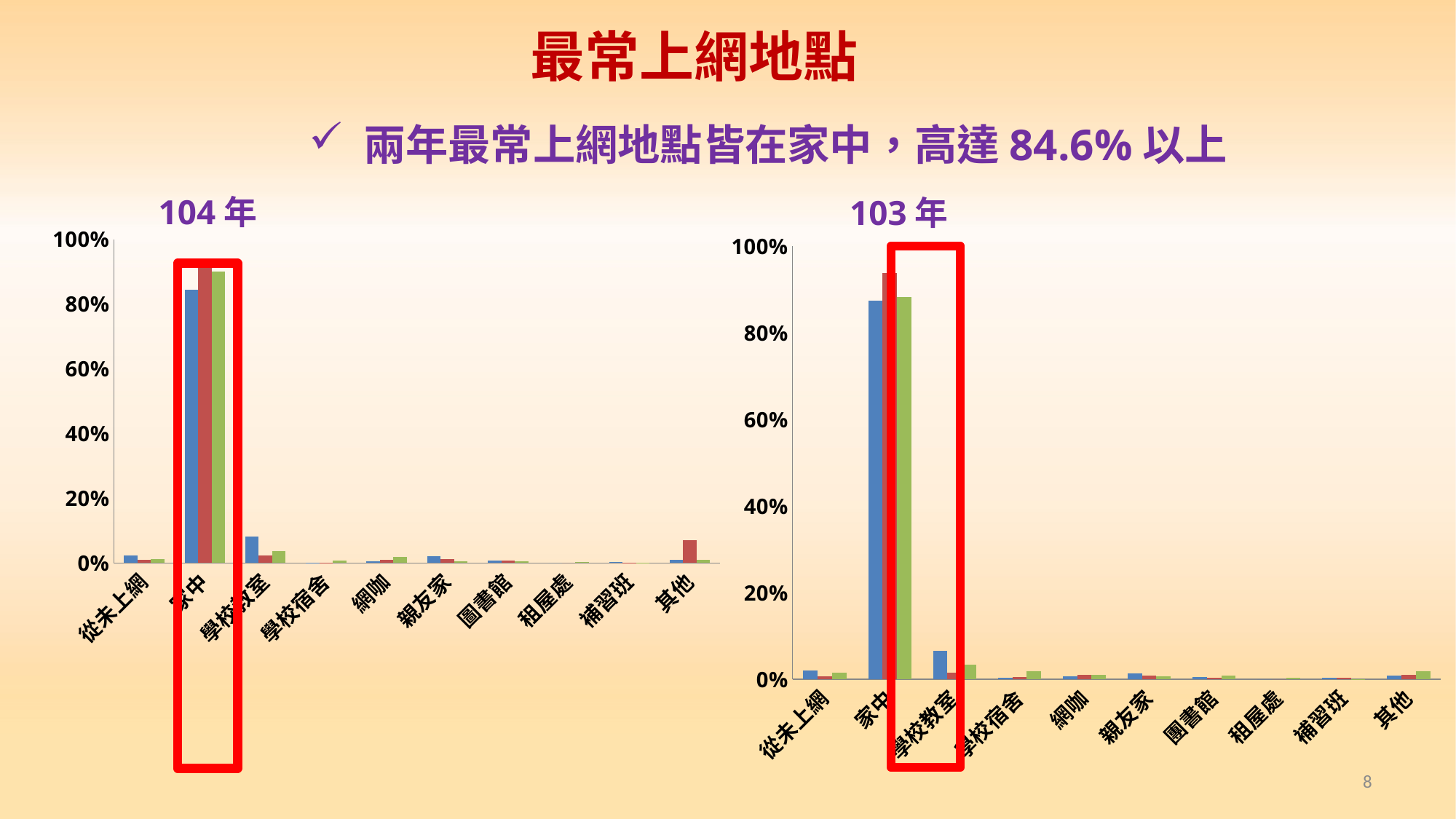
How many categories are shown on the x axis of the 104 年 chart? 10 In the 103 年 chart, is the value of the blue bar for 學校教室 greater or less than 20%? less In the 103 年 chart, which category has the highest bars? 家中 In the 104 年 chart, is the value of the blue bar for 家中 greater or less than 80%? greater How many categories are shown on the x axis of the 103 年 chart? 10 In the 104 年 chart, is the value of the blue bar for 學校教室 greater or less than 20%? less In the 103 年 chart, which category has the larger green bar, 家中 or 其他? 家中 What is the title shown above the left chart? 104 年 What kind of chart is the 104 年 chart on the left? bar chart In the 104 年 chart, which category has the highest bars? 家中 In the 104 年 chart, which category has the larger blue bar, 家中 or 學校教室? 家中